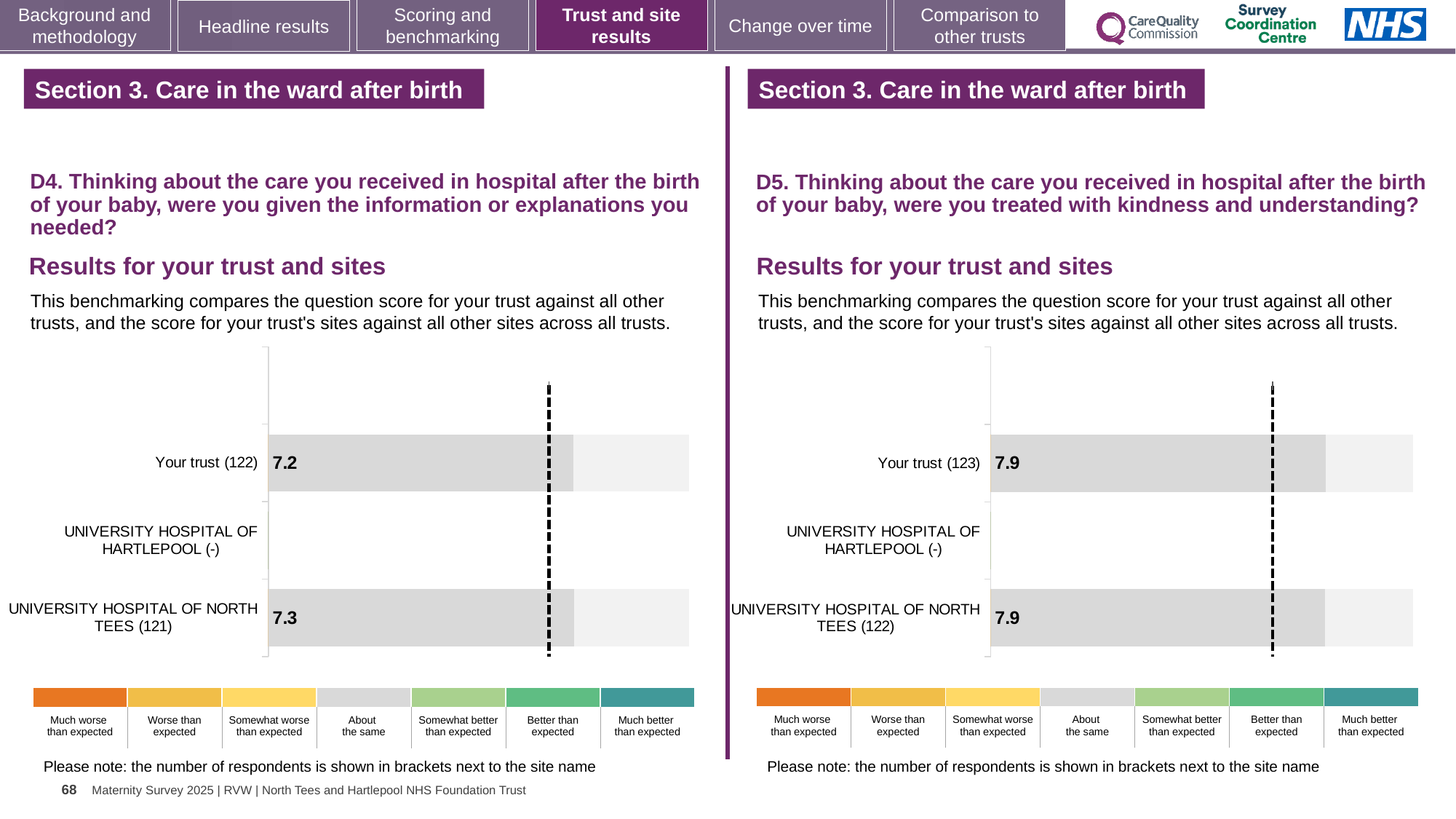
On the right chart (D5), what is the difference between the score for Your trust (123) and the score for UNIVERSITY HOSPITAL OF NORTH TEES (122)? 0 On the right chart (D5), what is the score for Your trust (123)? 7.9 On the left chart (D4), what is the score for Your trust (122)? 7.2 On the left chart (D4), what is the difference between the score for UNIVERSITY HOSPITAL OF NORTH TEES (121) and the score for Your trust (122)? 0.1 What kind of chart is the left chart (D4)? Bar chart How many categories are listed on the left chart (D4)? 3 On the left chart (D4), which has the higher score: Your trust (122) or UNIVERSITY HOSPITAL OF NORTH TEES (121)? UNIVERSITY HOSPITAL OF NORTH TEES (121) How many categories are listed on the right chart (D5)? 3 On the right chart (D5), what is the score for UNIVERSITY HOSPITAL OF NORTH TEES (122)? 7.9 On the left chart (D4), which category has no bar plotted? UNIVERSITY HOSPITAL OF HARTLEPOOL (-) On the left chart (D4), what is the score for UNIVERSITY HOSPITAL OF NORTH TEES (121)? 7.3 On the right chart (D5), how many respondents are shown in brackets for Your trust? 123